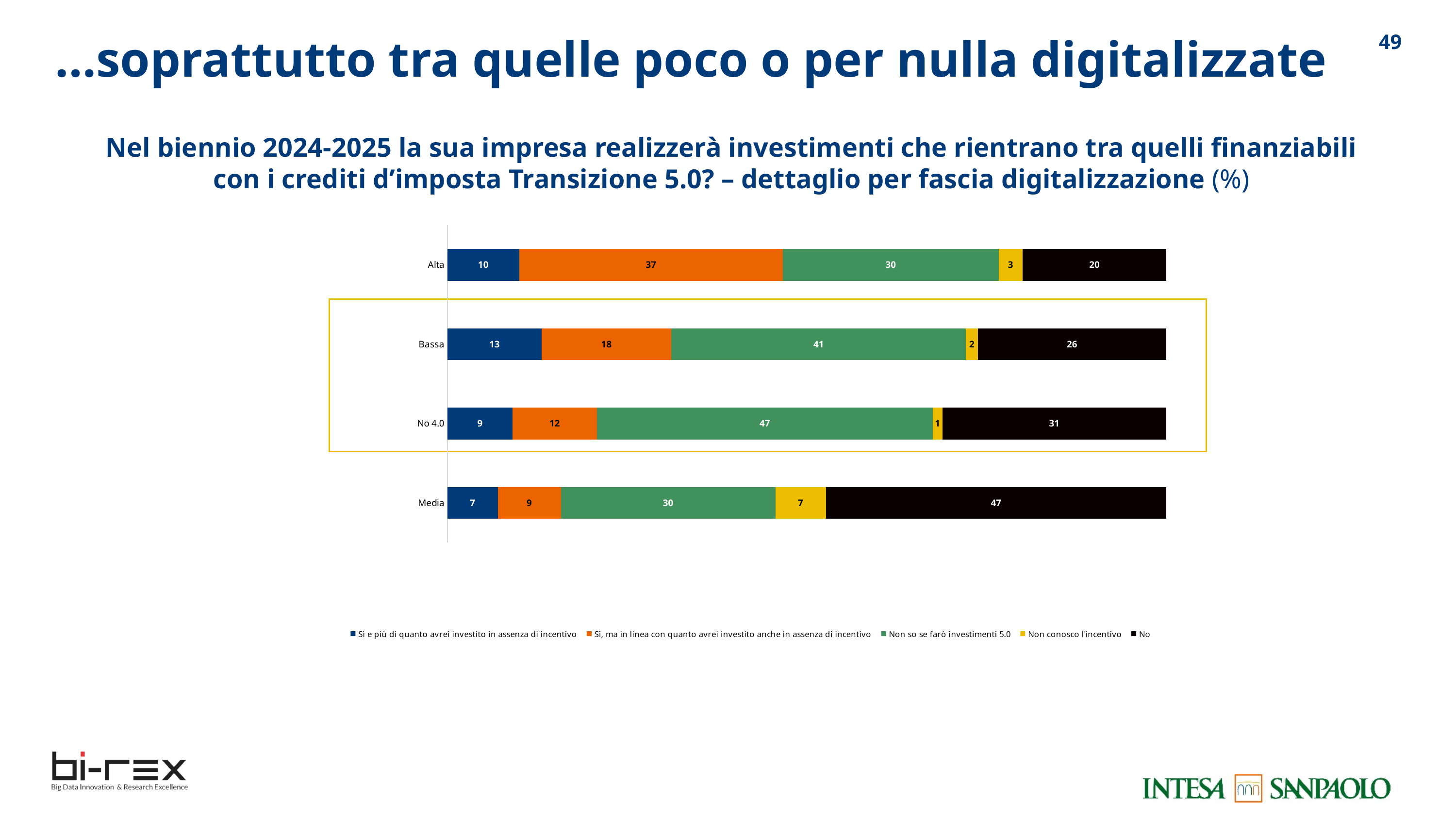
Which category has the lowest value for 'No'? Alta What is the value of 'No' for the 'Media' category? 47 How many series does the legend list? 5 What is the total of the stacked bar for the 'No 4.0' category? 100 What is the value of 'Non conosco l'incentivo' for the 'Bassa' category? 2 Which category has the highest value for 'Sì e più di quanto avrei investito in assenza di incentivo'? Bassa Which is larger: the 'Non so se farò investimenti 5.0' value for 'Bassa' or for 'Alta'? Bassa What is the difference between the 'No' values for 'Media' and 'Alta'? 27 How many categories (digitalisation bands) are plotted on the chart? 4 What is the value of 'Sì, ma in linea con quanto avrei investito anche in assenza di incentivo' for the 'Alta' category? 37 What kind of chart is shown on the slide? Stacked bar chart What is the value of 'Non so se farò investimenti 5.0' for the 'No 4.0' category? 47